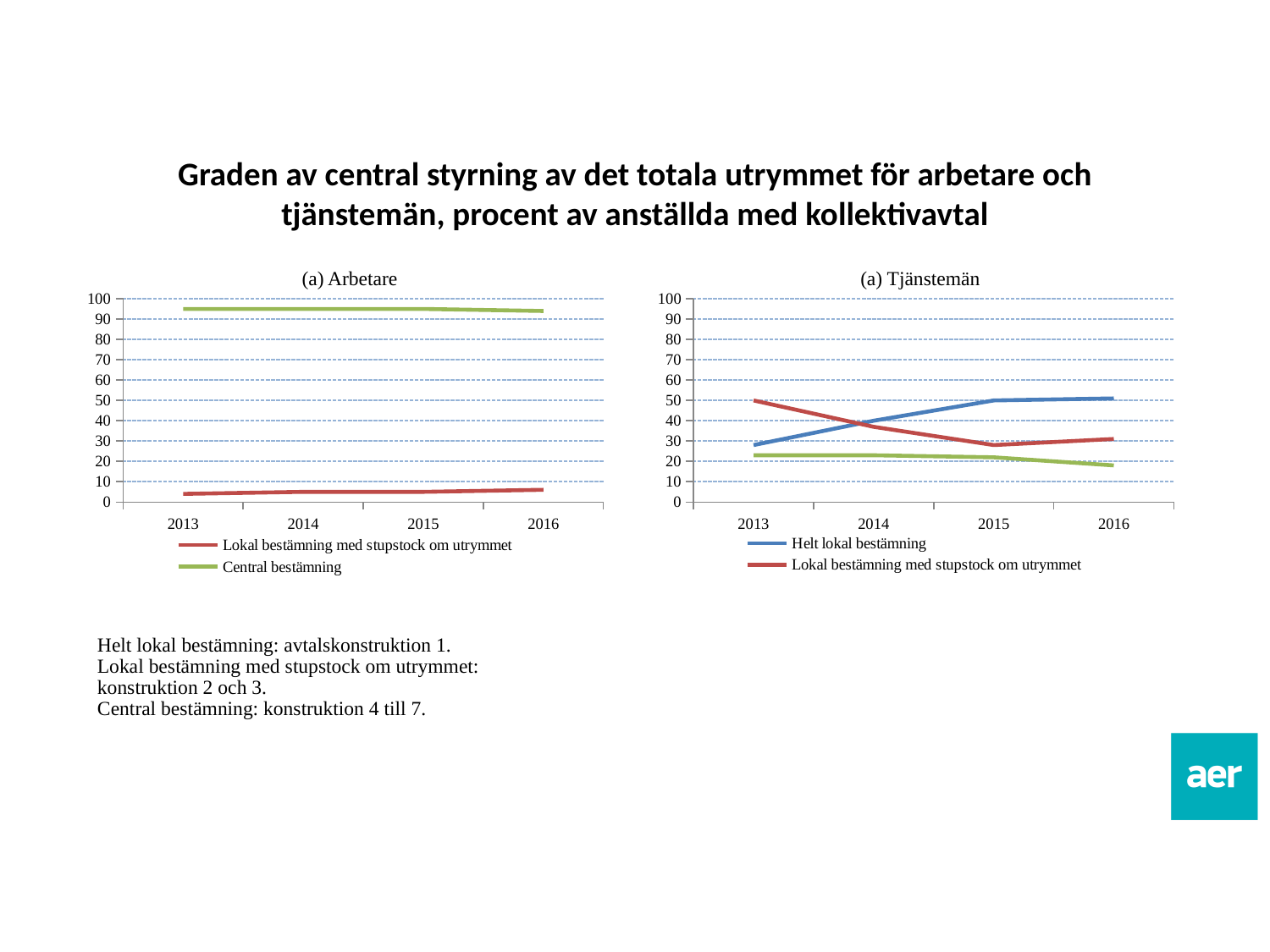
In the '(a) Arbetare' chart, is the value for 'Lokal bestämning med stupstock om utrymmet' in 2016 greater or less than 10? less In the '(a) Tjänstemän' chart, is the value for 'Helt lokal bestämning' in 2016 greater or less than 40? greater What colour is the 'Helt lokal bestämning' line in the '(a) Tjänstemän' chart? blue In the '(a) Tjänstemän' chart, does the 'Lokal bestämning med stupstock om utrymmet' line rise or fall from 2013 to 2015? fall In the '(a) Tjänstemän' chart, is the value for 'Helt lokal bestämning' in 2013 greater or less than 40? less What kind of chart is the '(a) Arbetare' chart? line chart In the '(a) Arbetare' chart, which series is higher in 2016, 'Central bestämning' or 'Lokal bestämning med stupstock om utrymmet'? Central bestämning How many years are shown on the x axis of the '(a) Tjänstemän' chart? 4 In the '(a) Tjänstemän' chart, does the 'Helt lokal bestämning' line rise or fall from 2013 to 2016? rise In the '(a) Tjänstemän' chart, which series is higher in 2013, 'Helt lokal bestämning' or 'Lokal bestämning med stupstock om utrymmet'? Lokal bestämning med stupstock om utrymmet How many series does the legend of the '(a) Arbetare' chart list? 2